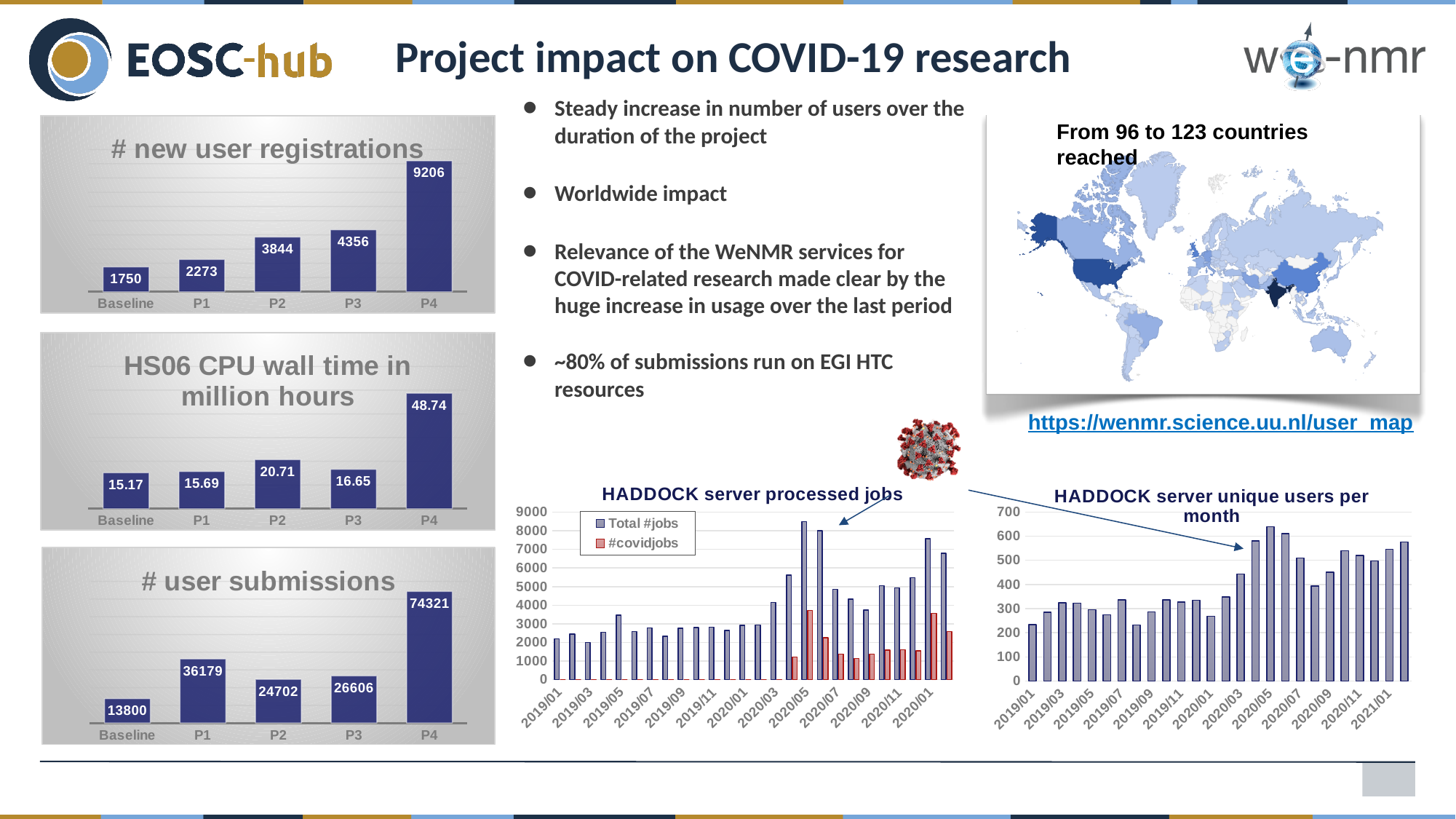
In the 'HS06 CPU wall time in million hours' chart, what is the value for P2? 20.71 In the '# user submissions' chart, what is the difference between the P1 and P2 values? 11477 What kind of chart is the 'HADDOCK server unique users per month' chart? bar chart In the 'HADDOCK server processed jobs' chart, is the Total #jobs value for 2020/05 greater or less than 8000? greater In the '# new user registrations' chart, what is the difference between the P4 and P3 values? 4850 In the 'HS06 CPU wall time in million hours' chart, which is larger, P1 or P3? P3 How many series does the legend of the 'HADDOCK server processed jobs' chart list? 2 In the '# new user registrations' chart, which period has the highest value? P4 In the '# user submissions' chart, what is the value for P1? 36179 How many categories are shown on the x axis of the '# user submissions' chart? 5 In the 'HS06 CPU wall time in million hours' chart, which period has the lowest value? Baseline In the '# new user registrations' chart, what is the value for P4? 9206